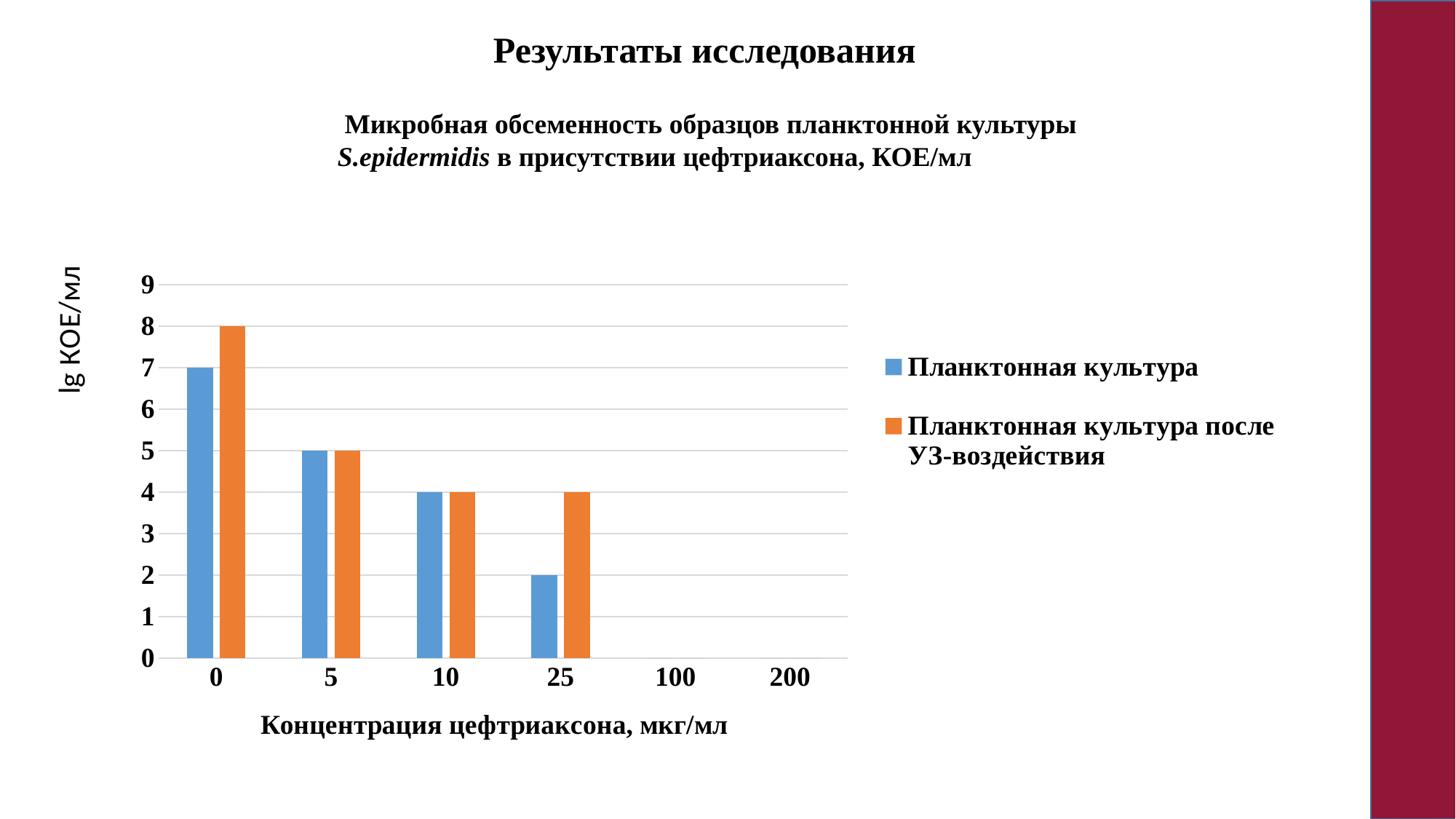
What type of chart is shown on the slide? bar chart How many concentration categories are shown on the x axis? 6 Which series has the larger value at concentration 0 мкг/мл? Планктонная культура после УЗ-воздействия What is the value for 'Планктонная культура' at concentration 25 мкг/мл? 2 What is the value for 'Планктонная культура после УЗ-воздействия' at concentration 0 мкг/мл? 8 What is the value for 'Планктонная культура' at concentration 0 мкг/мл? 7 At which concentration is the value for 'Планктонная культура' highest? 0 Do the values for 'Планктонная культура' rise or fall as the concentration increases from 0 to 25 мкг/мл? fall What is the value for 'Планктонная культура после УЗ-воздействия' at concentration 25 мкг/мл? 4 How many series does the legend list? 2 What is the label of the x axis? Концентрация цефтриаксона, мкг/мл What is the difference between the two series at concentration 25 мкг/мл? 2